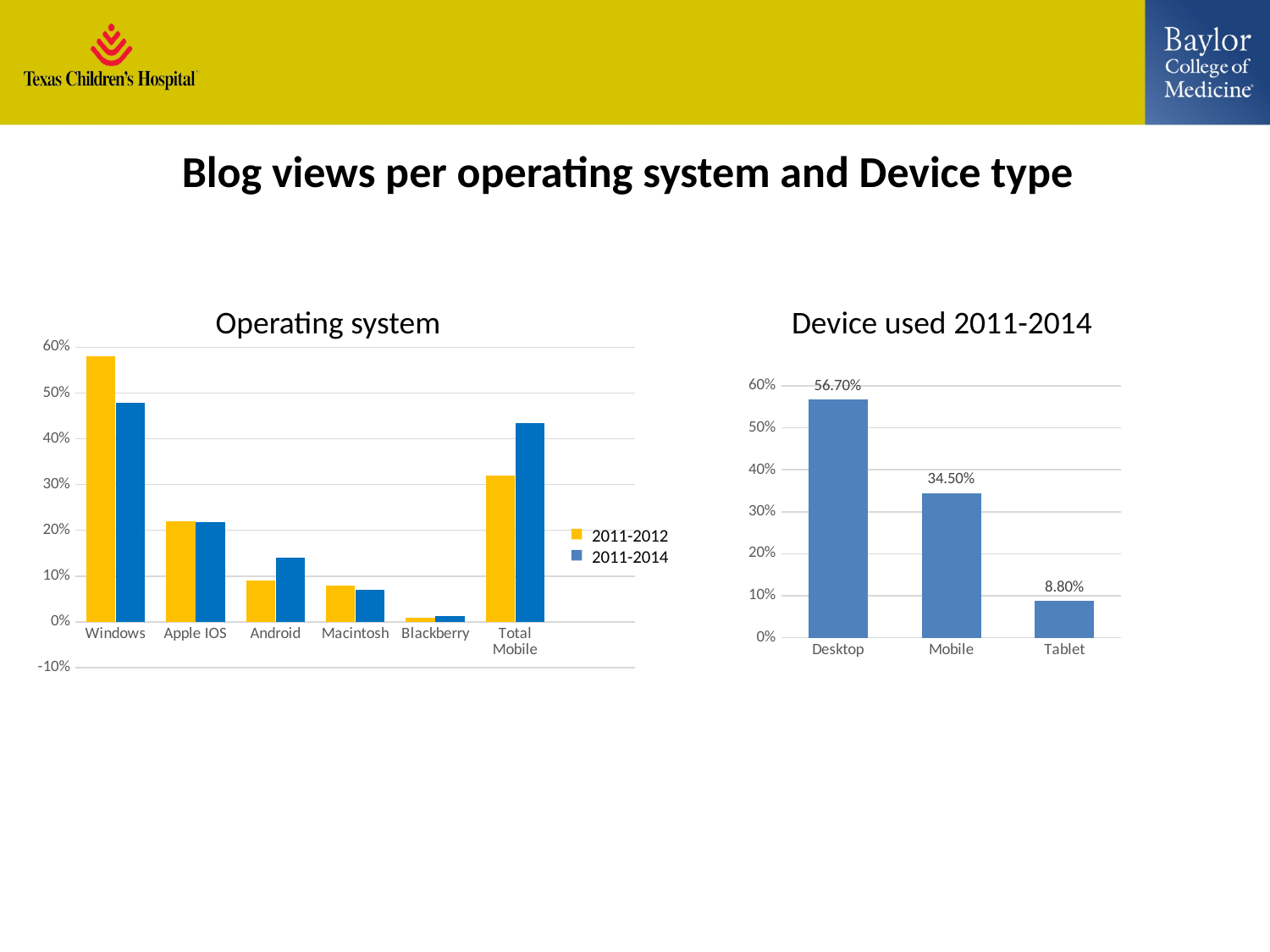
In the 'Device used 2011-2014' chart, how many device categories are shown? 3 In the 'Device used 2011-2014' chart, what is the value for Desktop? 56.70% What kind of chart is the 'Operating system' chart? Bar chart In the 'Device used 2011-2014' chart, what is the difference between the Desktop and Mobile values? 22.20% In the 'Device used 2011-2014' chart, what is the value for Tablet? 8.80% In the 'Operating system' chart, for Android, which series has the larger value: 2011-2012 or 2011-2014? 2011-2014 In the 'Device used 2011-2014' chart, which device has the highest value? Desktop In the 'Operating system' chart, how many categories are shown on the x axis? 6 In the 'Operating system' chart, how many series does the legend list? 2 In the 'Device used 2011-2014' chart, which device has the lowest value? Tablet In the 'Device used 2011-2014' chart, what is the value for Mobile? 34.50% In the 'Operating system' chart, is the 2011-2012 value for Windows greater or less than 50%? greater